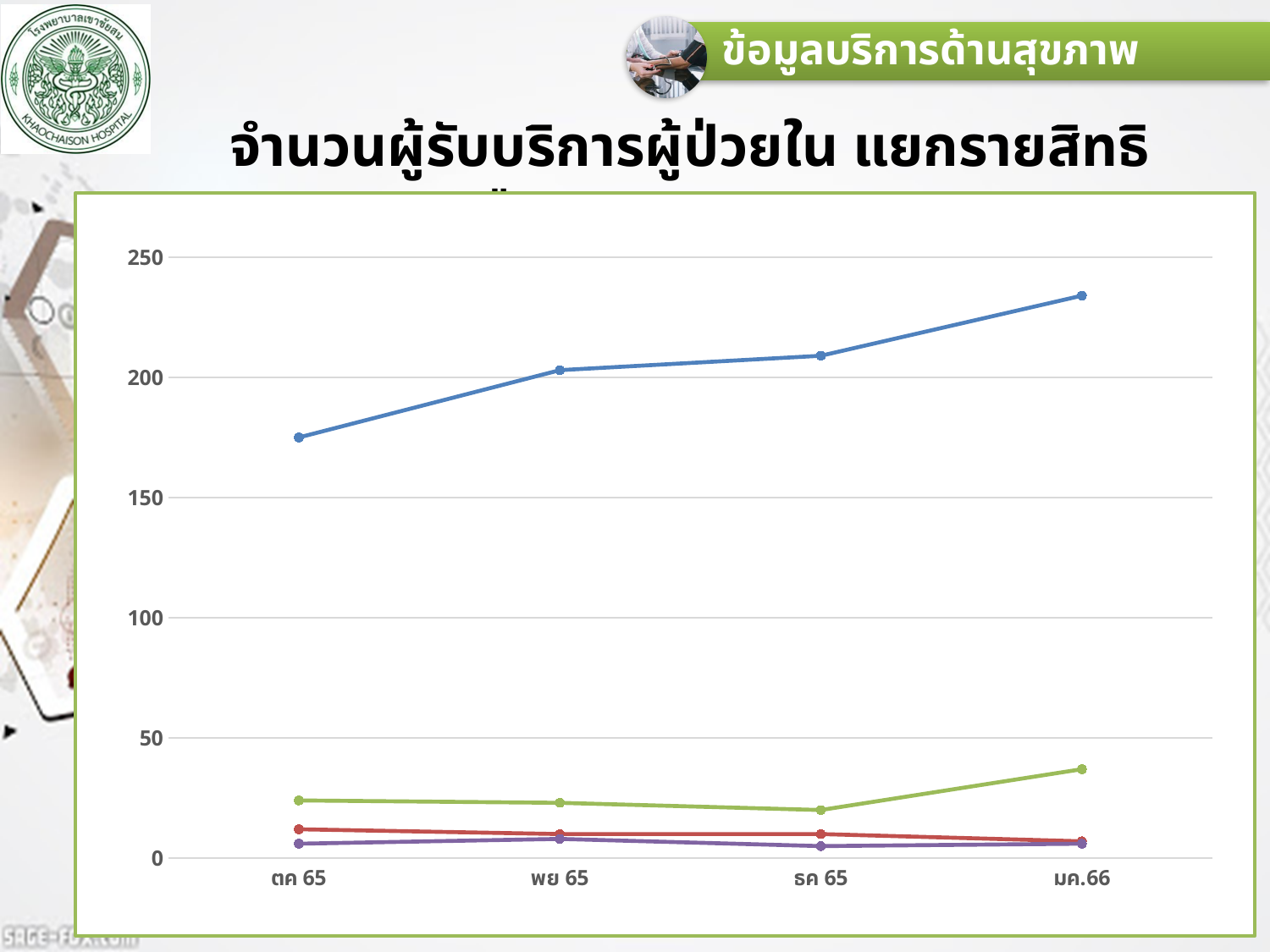
Is the value of the blue line at มค.66 greater or less than 200? greater At มค.66, which line has the larger value, the blue line or the green line? blue How many lines are plotted on the chart? 4 What kind of chart is shown on the slide? line chart In which month does the green line reach its highest value? มค.66 How many categories are shown on the x axis of the chart? 4 Is the value of the blue line at ตค 65 greater or less than 150? greater In which month does the blue line reach its highest value? มค.66 Does the blue line rise or fall from ตค 65 to มค.66? rise In which month does the blue line have its lowest value? ตค 65 Is the value of the green line at มค.66 greater or less than 50? less